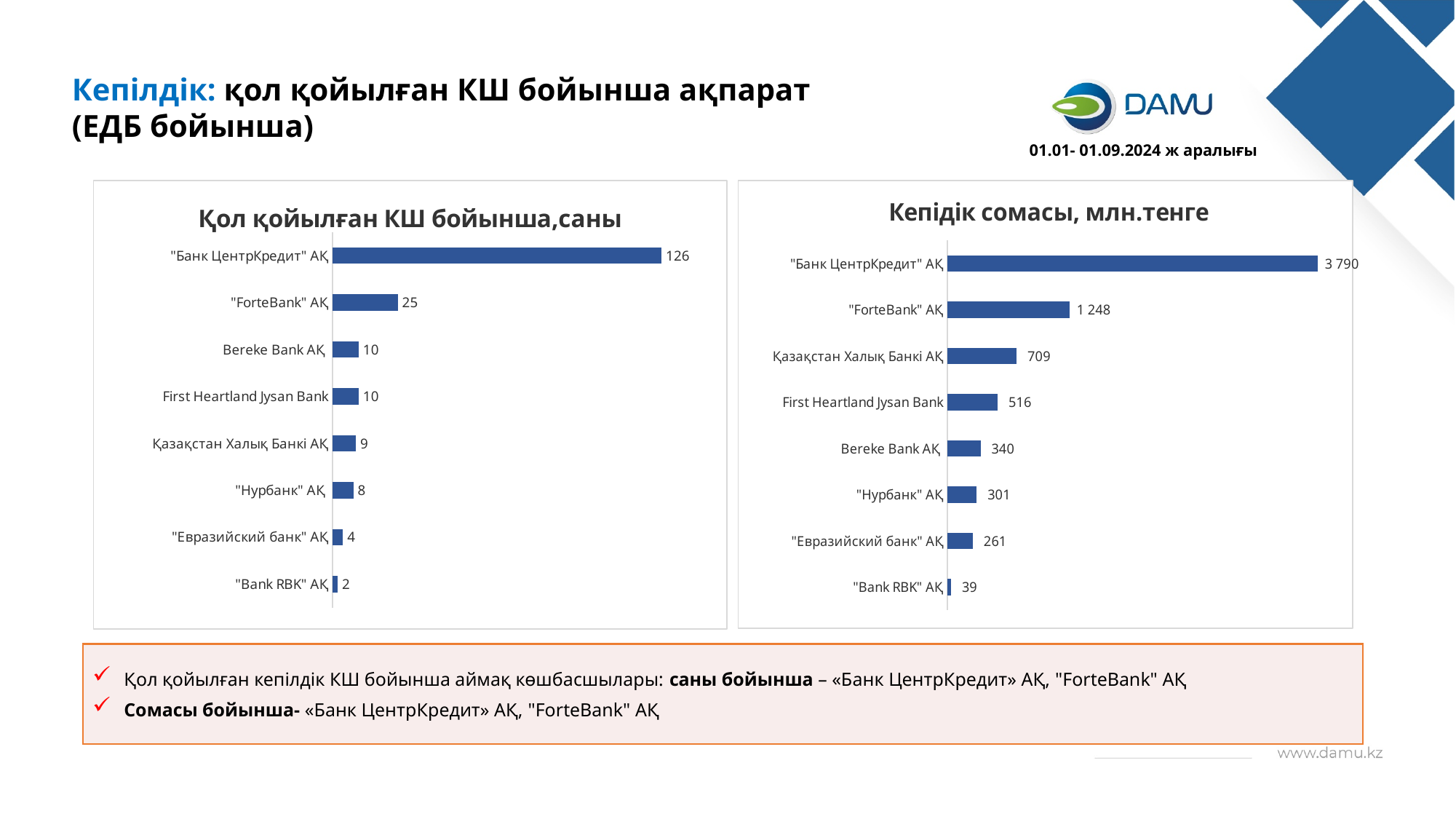
In the right chart 'Кепідік сомасы, млн.тенге', what is the value for Қазақстан Халық Банкі АҚ? 709 In the right chart 'Кепідік сомасы, млн.тенге', what is the difference between "Нурбанк" АҚ and "Евразийский банк" АҚ? 40 In the left chart 'Қол қойылған КШ бойынша,саны', which bank has the highest value? "Банк ЦентрКредит" АҚ In the left chart 'Қол қойылған КШ бойынша,саны', which bank has the lowest value? "Bank RBK" АҚ In the left chart 'Қол қойылған КШ бойынша,саны', how many banks are shown? 8 What type of chart is the left chart 'Қол қойылған КШ бойынша,саны'? Bar chart In the right chart 'Кепідік сомасы, млн.тенге', what is the value for "Bank RBK" АҚ? 39 What is the title of the right chart? Кепідік сомасы, млн.тенге In the right chart 'Кепідік сомасы, млн.тенге', which bank has the highest value? "Банк ЦентрКредит" АҚ In the right chart 'Кепідік сомасы, млн.тенге', which is larger: First Heartland Jysan Bank or Bereke Bank АҚ? First Heartland Jysan Bank In the left chart 'Қол қойылған КШ бойынша,саны', what is the difference between "Банк ЦентрКредит" АҚ and "ForteBank" АҚ? 101 In the left chart 'Қол қойылған КШ бойынша,саны', what is the value for "ForteBank" АҚ? 25